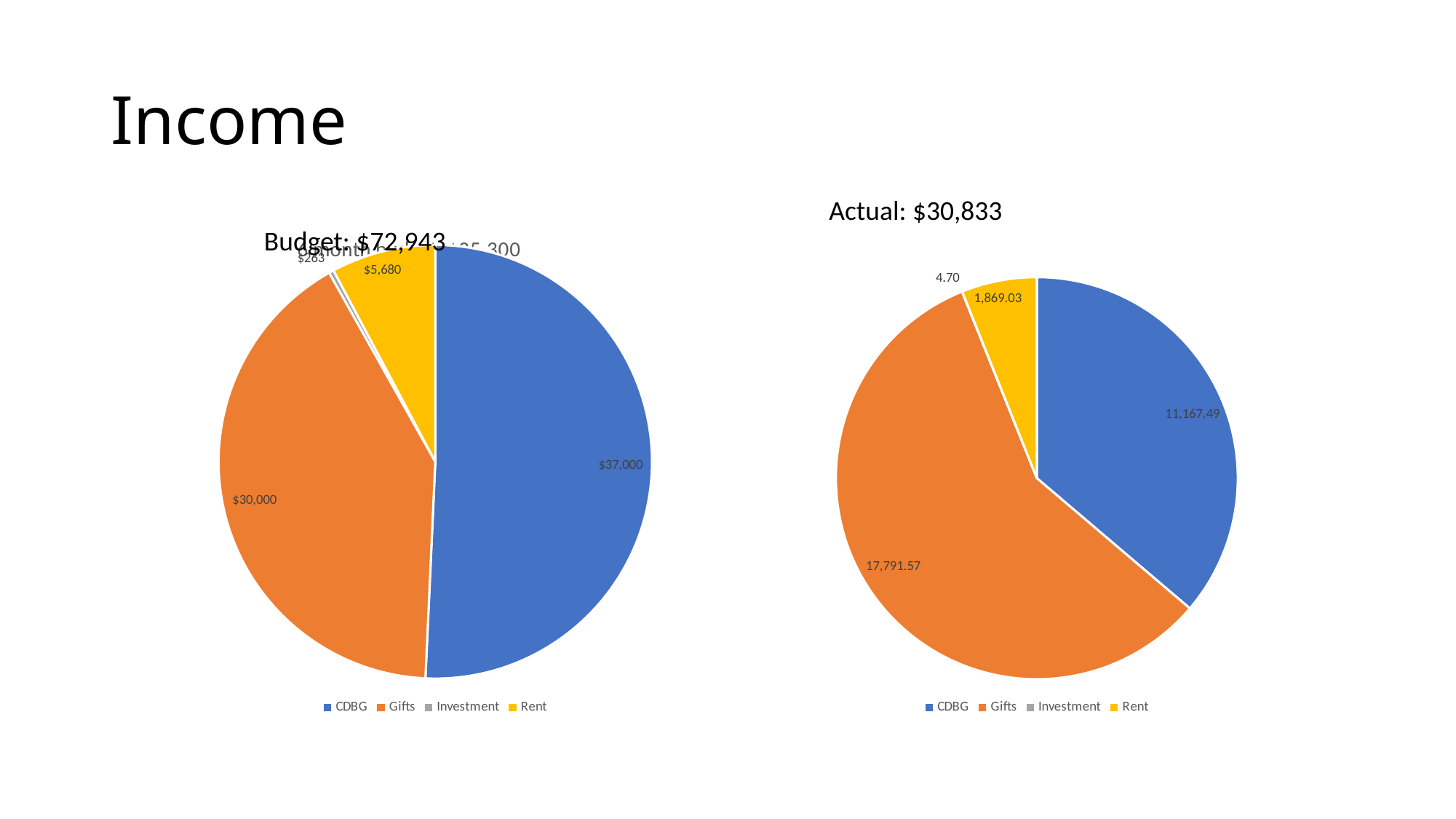
In the right (Actual) pie chart, what is the value shown for Investment? 4.70 In the right (Actual) pie chart, what is the value shown for Rent? 1,869.03 In the left (Budget) pie chart, what is the value shown for CDBG? $37,000 In the right (Actual) pie chart, what is the value shown for Gifts? 17,791.57 In the right (Actual) pie chart, which category has the largest slice? Gifts What kind of chart is used on the right side of the slide (Actual)? Pie chart In the left (Budget) pie chart, which category has the largest slice? CDBG In the left (Budget) pie chart, what is the value shown for Gifts? $30,000 In the right (Actual) pie chart, what is the value shown for CDBG? 11,167.49 In the left (Budget) pie chart, what is the value shown for Rent? $5,680 How many categories does the legend of the left (Budget) pie chart list? 4 In the left (Budget) pie chart, what is the difference between the CDBG and Gifts values? $7,000